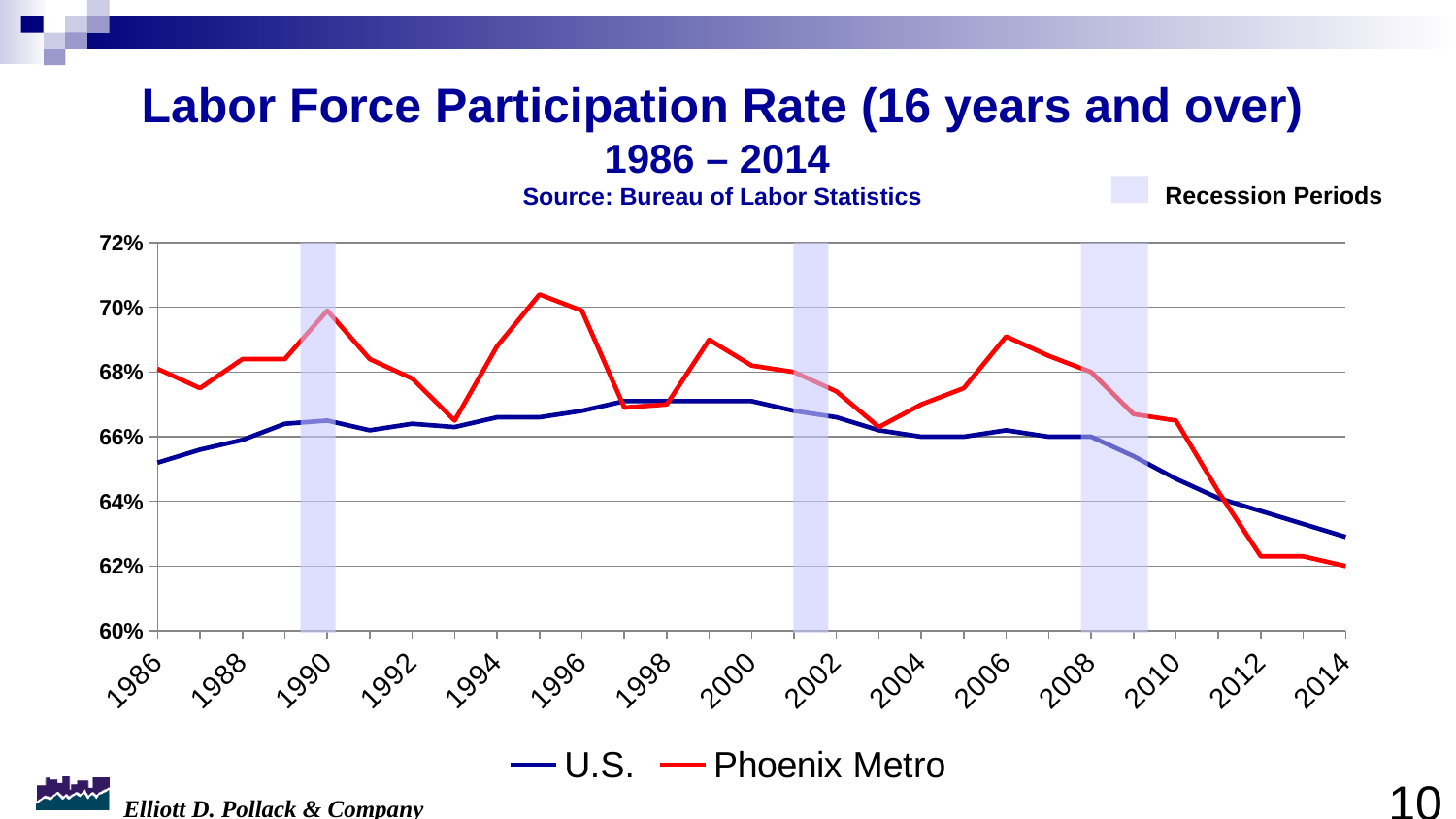
Is the Phoenix Metro value for 1990 greater or less than 68%? greater How many year labels are shown on the x axis? 15 What kind of chart is shown on the slide? Line chart In 2014, which series has the higher labor force participation rate, U.S. or Phoenix Metro? U.S. In 1996, which series has the higher labor force participation rate, U.S. or Phoenix Metro? Phoenix Metro What do the shaded vertical bands on the chart represent? Recession Periods Is the Phoenix Metro value for 2014 greater or less than 64%? less Is the U.S. value for 1986 greater or less than 66%? less What are the two series named in the legend? U.S. and Phoenix Metro How many series does the legend list? 2 Does the U.S. line rise or fall from 2008 to 2014? Fall